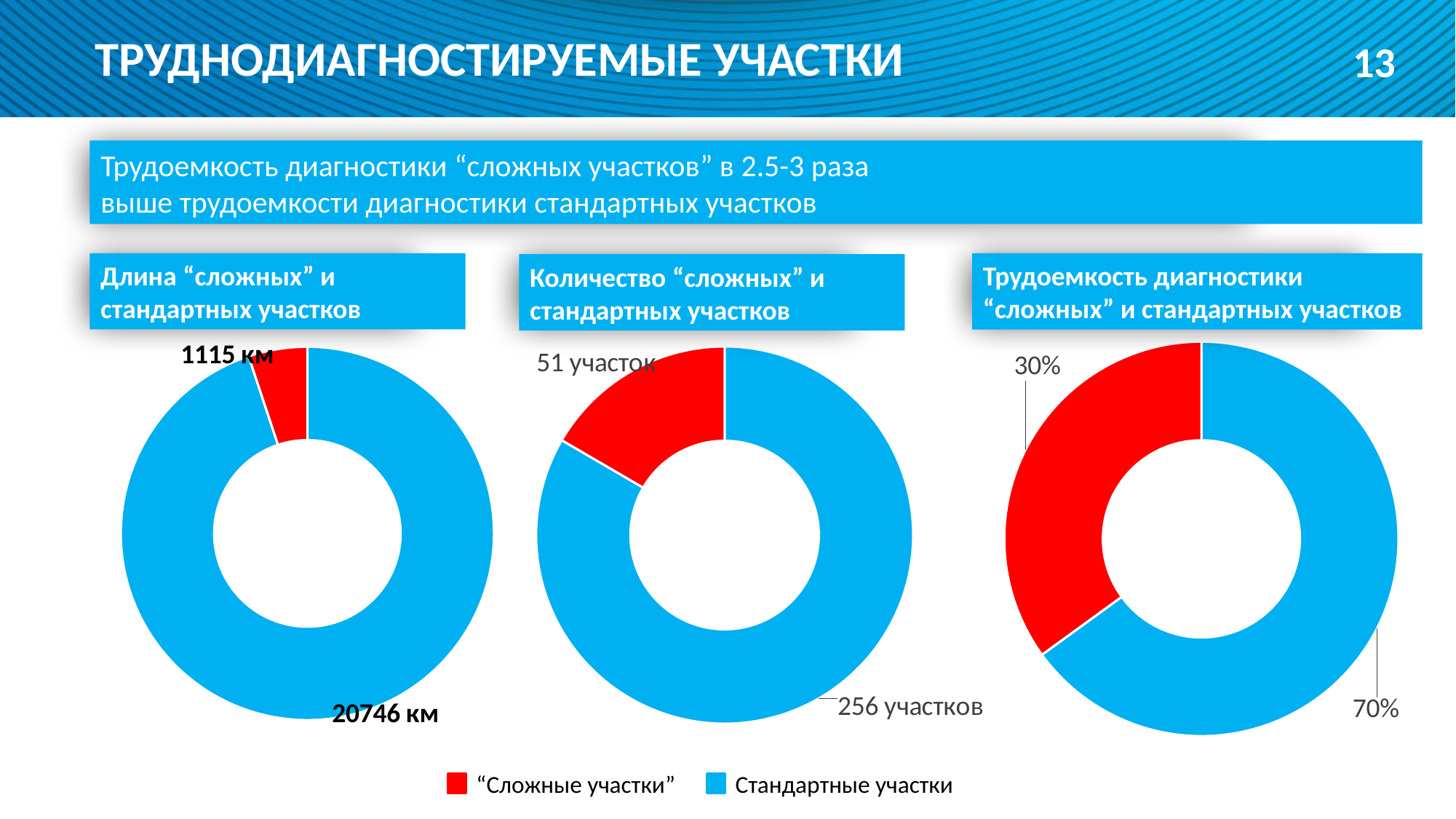
On the chart "Количество “сложных” и стандартных участков", what is the value for Стандартные участки? 256 участков On the chart "Длина “сложных” и стандартных участков", what is the difference between the length of standard and complex sections? 19631 км On the chart "Длина “сложных” и стандартных участков", what is the value for “Сложные участки”? 1115 км On the chart "Количество “сложных” и стандартных участков", what is the value for “Сложные участки”? 51 участок How many entries does the shared legend at the bottom of the slide list? 2 On the chart "Трудоемкость диагностики “сложных” и стандартных участков", what share do Стандартные участки have? 70% What kind of chart is used on the slide for "Трудоемкость диагностики “сложных” и стандартных участков"? Doughnut (pie) chart On the chart "Количество “сложных” и стандартных участков", which category has the smaller value? “Сложные участки” On the chart "Количество “сложных” и стандартных участков", what is the difference between the number of standard and complex sections? 205 On the chart "Длина “сложных” и стандартных участков", which category has the larger value? Стандартные участки On the chart "Трудоемкость диагностики “сложных” и стандартных участков", what share do “Сложные участки” have? 30% On the chart "Длина “сложных” и стандартных участков", what is the value for Стандартные участки? 20746 км